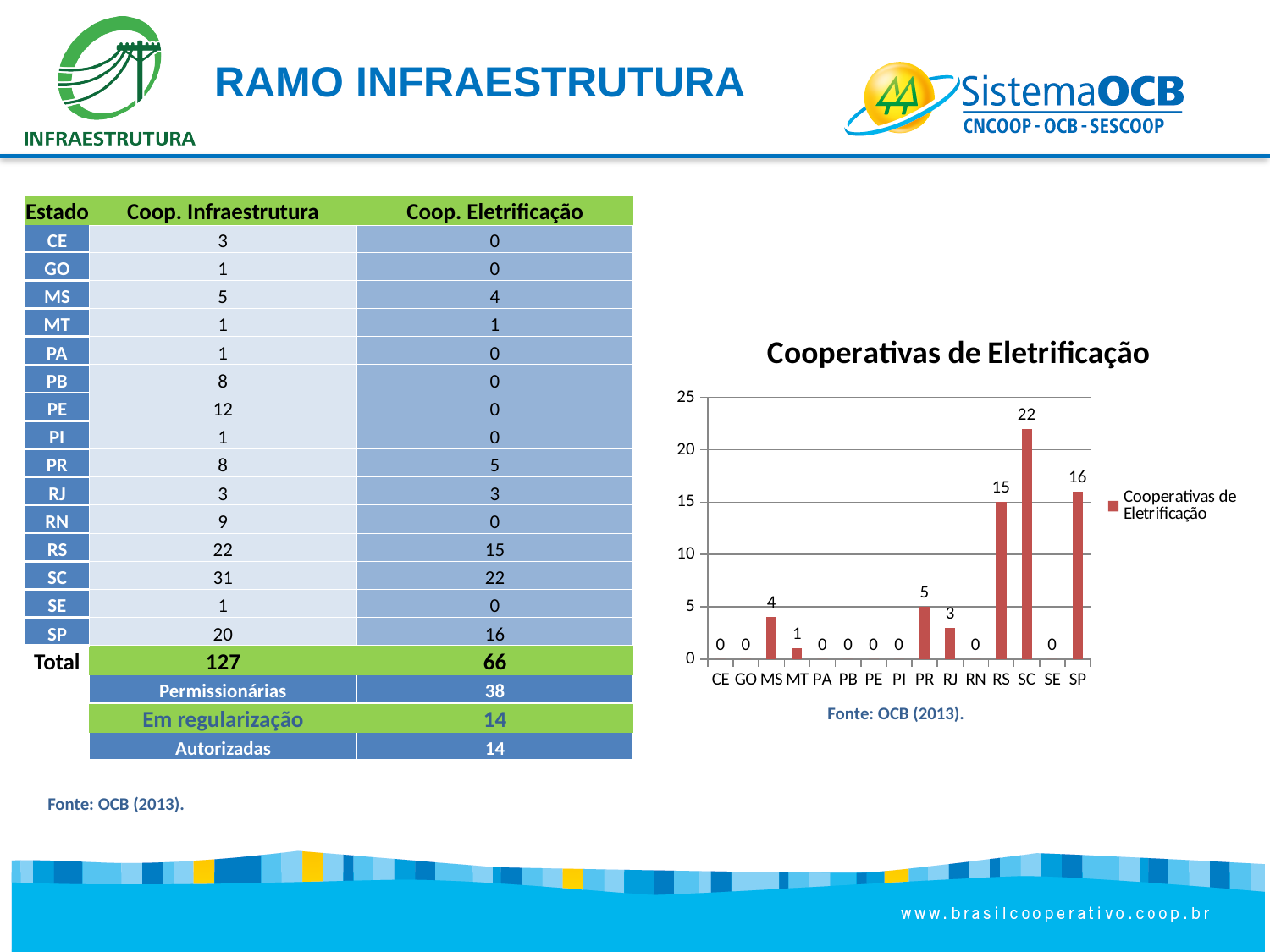
What is the value for SC in the chart? 22 How many series does the legend list? 1 Which state has the highest value in the chart? SC What is the title of the chart? Cooperativas de Eletrificação Which is larger, the value for MS or the value for RJ? MS What is the value for PR in the chart? 5 What is the difference between the values for SC and SP? 6 What type of chart is shown? bar chart What is the value for MT in the chart? 1 What is the value for RS in the chart? 15 How many states are shown on the x axis of the chart? 15 Is the value for SC greater or less than 20? greater